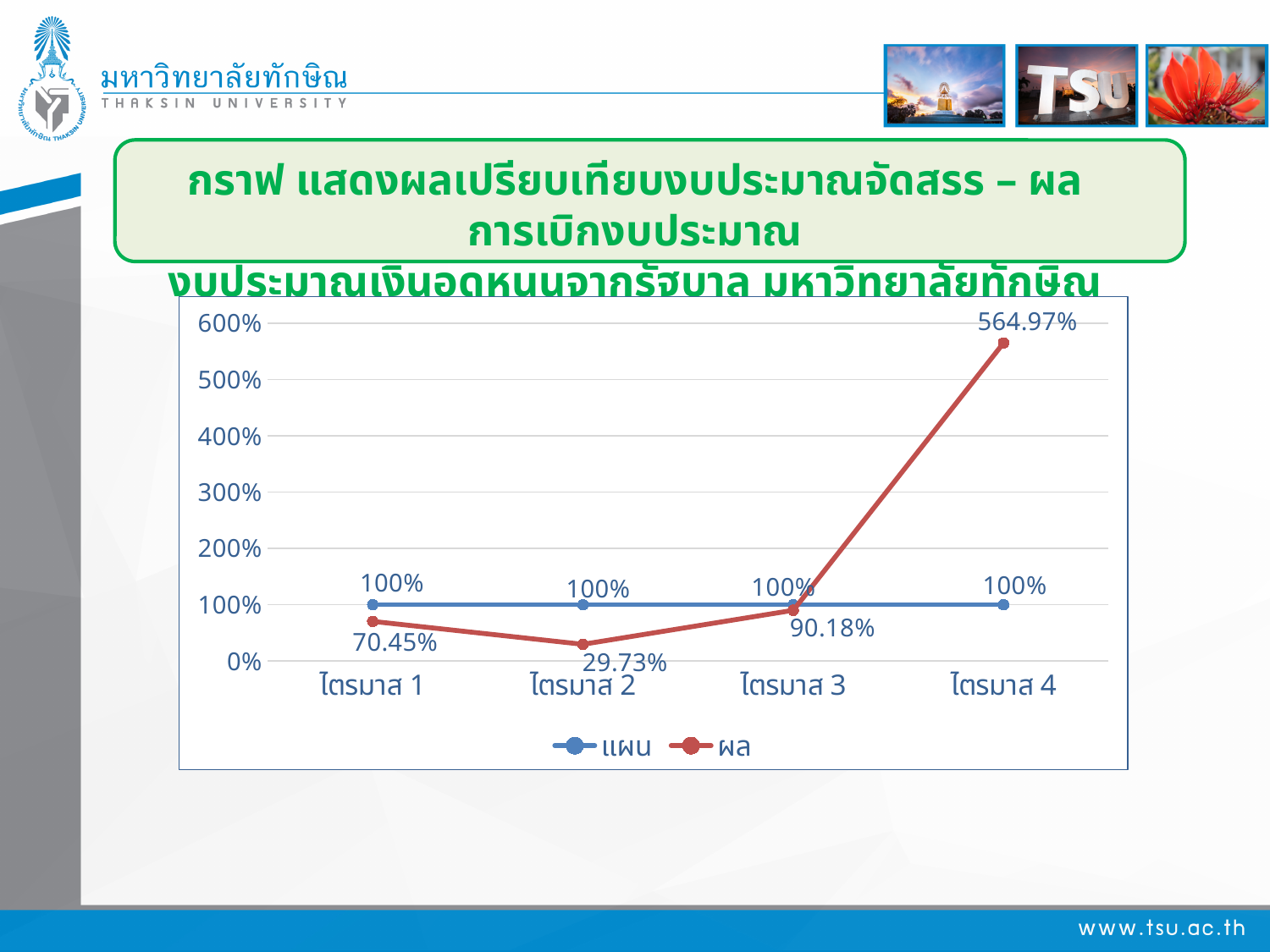
What is the value of ผล for ไตรมาส 1? 70.45% What is the difference between the ผล value for ไตรมาส 3 and the ผล value for ไตรมาส 1? 19.73% Which series is drawn in red? ผล How many quarters (categories) are shown on the x axis? 4 What is the value of แผน for ไตรมาส 3? 100% What is the value of ผล for ไตรมาส 4? 564.97% How many series does the legend list? 2 What type of chart is shown on the slide? line chart In which quarter is the ผล value the lowest? ไตรมาส 2 Which is larger for ไตรมาส 3: the แผน value or the ผล value? แผน What is the value of ผล for ไตรมาส 2? 29.73% In which quarter is the ผล value the highest? ไตรมาส 4